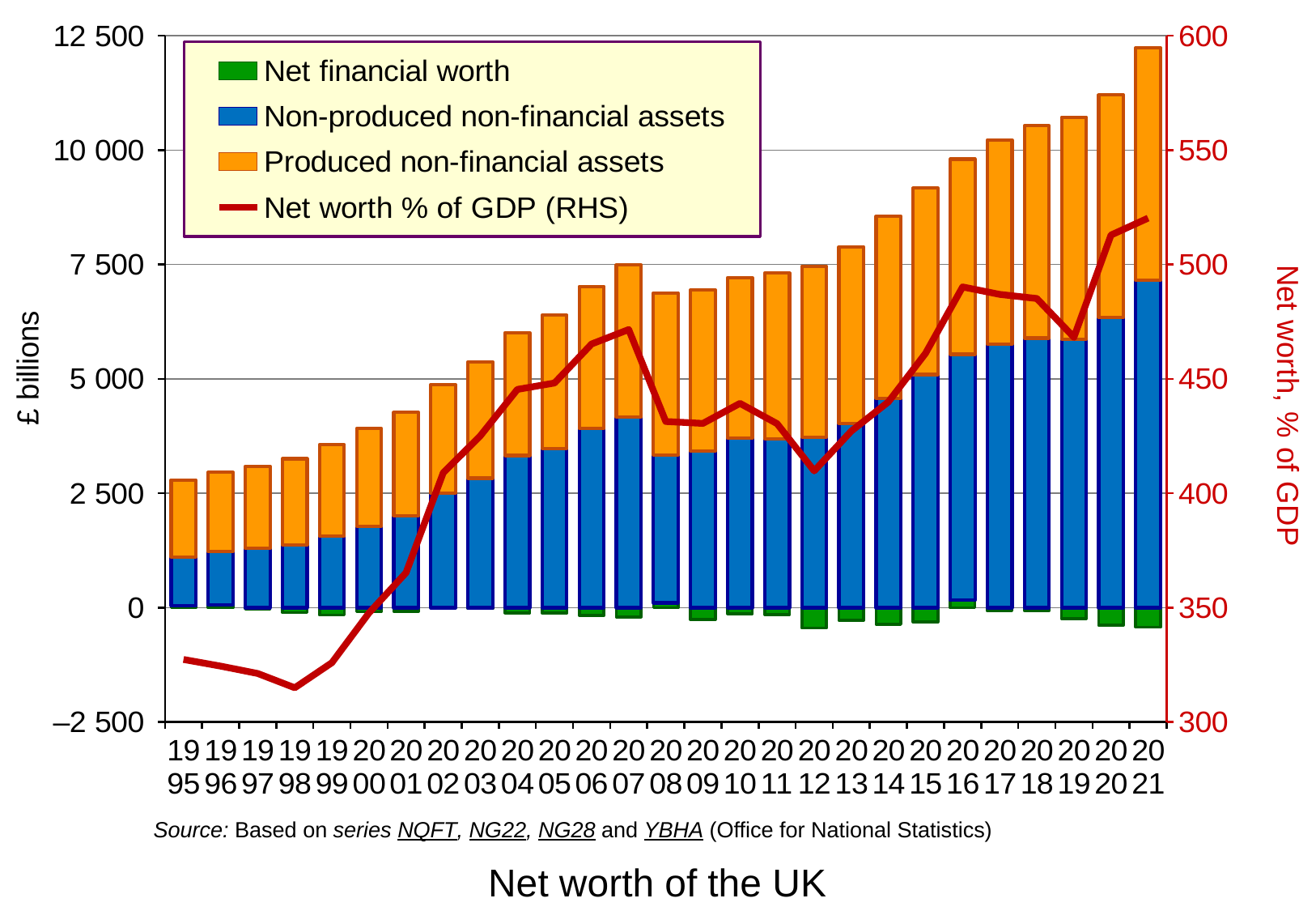
Which series is plotted on the right-hand axis? Net worth % of GDP (RHS) What is the title of the chart? Net worth of the UK Is the top of the stacked bar for 1995 greater or less than 5 000 £ billions? less Is the value of Net worth % of GDP in 1998 greater or less than 350? less In which year is Net worth % of GDP at its lowest? 1998 Is the value of Net worth % of GDP in 2021 greater or less than 500? greater How many years are shown along the x axis? 27 Which year has the higher Net worth % of GDP, 2007 or 2012? 2007 How many series does the legend list? 4 In which year is the stacked bar tallest? 2021 What kind of chart is shown on the slide? A stacked bar chart with a line Does Net worth % of GDP rise or fall between 1998 and 2007? rise